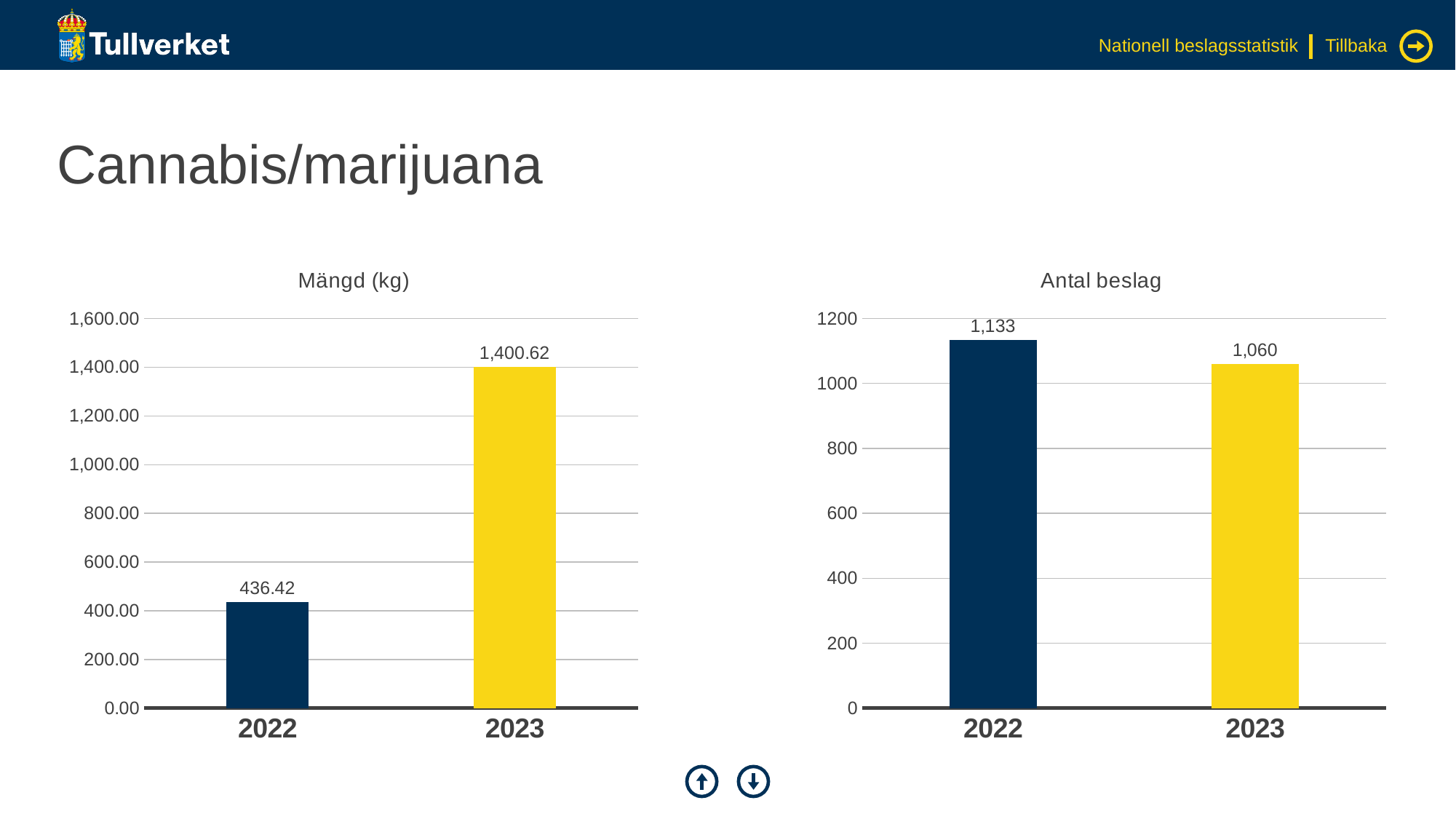
What kind of chart is the 'Mängd (kg)' chart? bar chart In the 'Mängd (kg)' chart, what is the value for 2022? 436.42 In the 'Antal beslag' chart, is the value for 2022 greater or less than 1000? greater In the 'Mängd (kg)' chart, which year has the highest value? 2023 In the 'Antal beslag' chart, what is the value for 2023? 1,060 In the 'Mängd (kg)' chart, do the values rise or fall from 2022 to 2023? rise In the 'Antal beslag' chart, which year has the lowest value? 2023 In the 'Antal beslag' chart, what is the value for 2022? 1,133 In the 'Antal beslag' chart, what is the difference between the 2022 and 2023 values? 73 In the 'Mängd (kg)' chart, what is the value for 2023? 1,400.62 How many categories does the 'Antal beslag' chart show? 2 In the 'Mängd (kg)' chart, what is the difference between the 2023 and 2022 values? 964.20